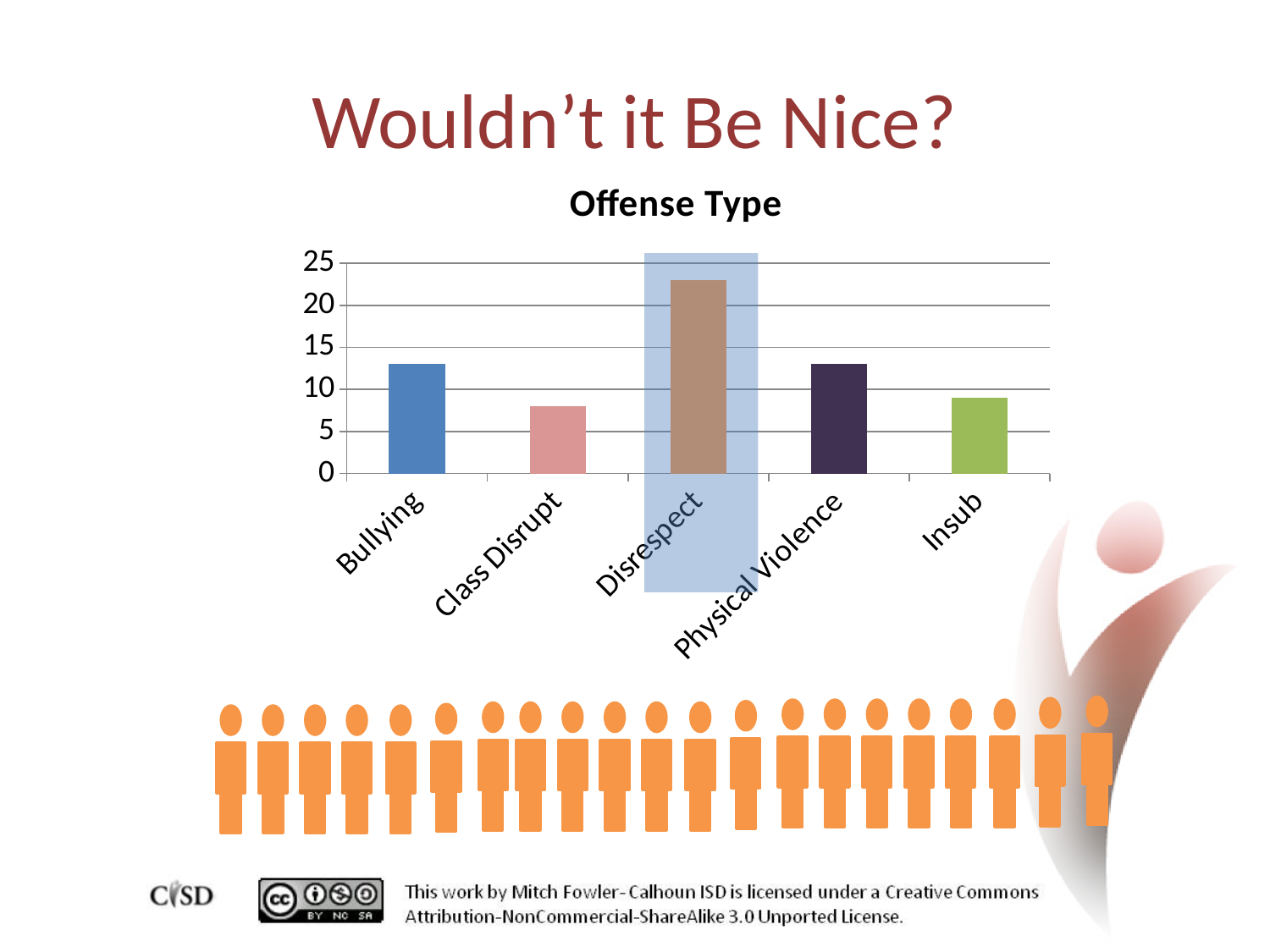
Is the value for Bullying greater or less than 10? greater Is the value for Class Disrupt greater or less than 10? less Is the value for Disrespect greater or less than 20? greater What is the title of the chart on the slide? Offense Type Which is larger, the value for Disrespect or the value for Bullying? Disrespect Which offense type has the highest bar in the chart? Disrespect How many offense categories are shown on the x axis of the chart? 5 Which is larger, the value for Physical Violence or the value for Class Disrupt? Physical Violence What type of chart is shown under the title "Offense Type"? bar chart